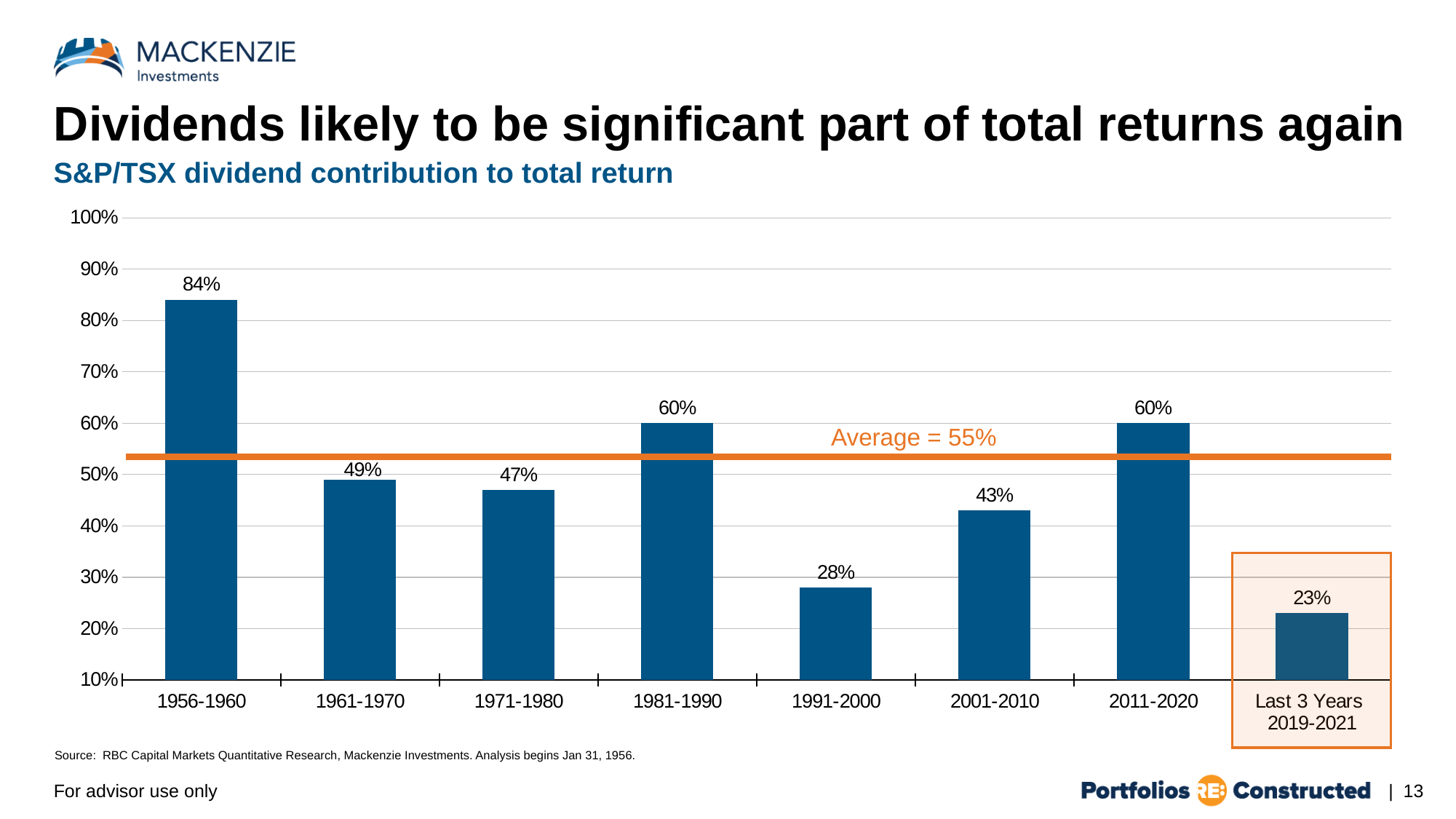
What is the difference between the values for 1956-1960 and 1991-2000? 56% What kind of chart is shown on the slide? Bar chart What is the value shown for Last 3 Years 2019-2021? 23% Which period has the highest dividend contribution to total return? 1956-1960 Is the value for 1981-1990 greater or less than the average line of 55%? greater How many periods are shown on the x axis? 8 What is the difference between the value for 2011-2020 and the value for Last 3 Years 2019-2021? 37% What is the dividend contribution to total return for 1956-1960? 84% What is the value shown for 1991-2000? 28% Which is larger, the value for 1961-1970 or the value for 2001-2010? 1961-1970 What average value is indicated by the orange horizontal line? 55% Which period has the lowest dividend contribution to total return? Last 3 Years 2019-2021